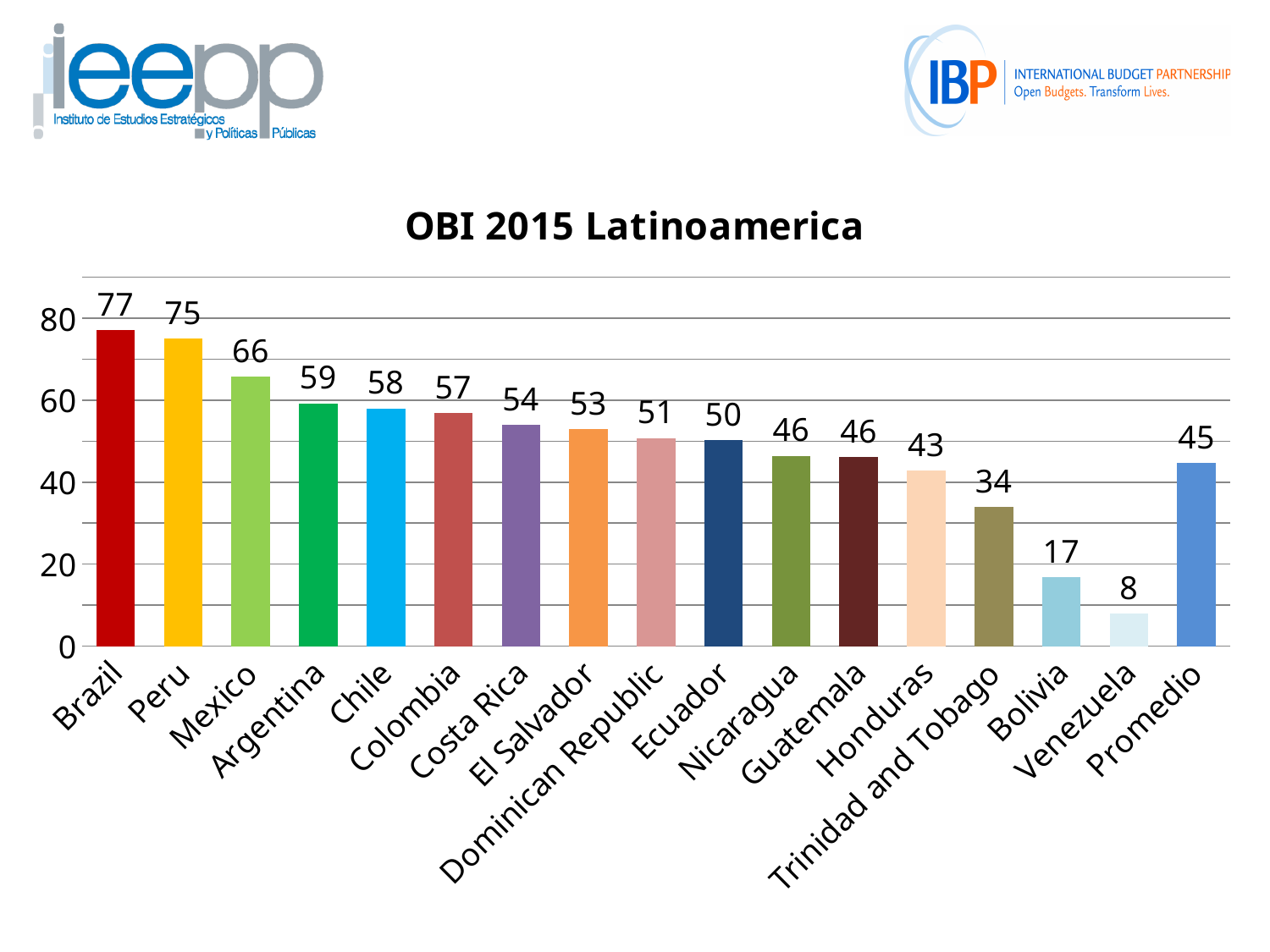
What is the difference between the values for Trinidad and Tobago and Bolivia? 17 Which is larger, the value for Chile or the value for Ecuador? Chile How many categories are shown on the x axis? 17 Is the value for Costa Rica greater or less than 40? greater What is the value for Promedio? 45 What is the value for Mexico? 66 Which category has the lowest value? Venezuela What is the value for Honduras? 43 What kind of chart is shown on the slide? bar chart What is the title of the chart? OBI 2015 Latinoamerica Which category has the highest value? Brazil What is the difference between the values for Brazil and Peru? 2